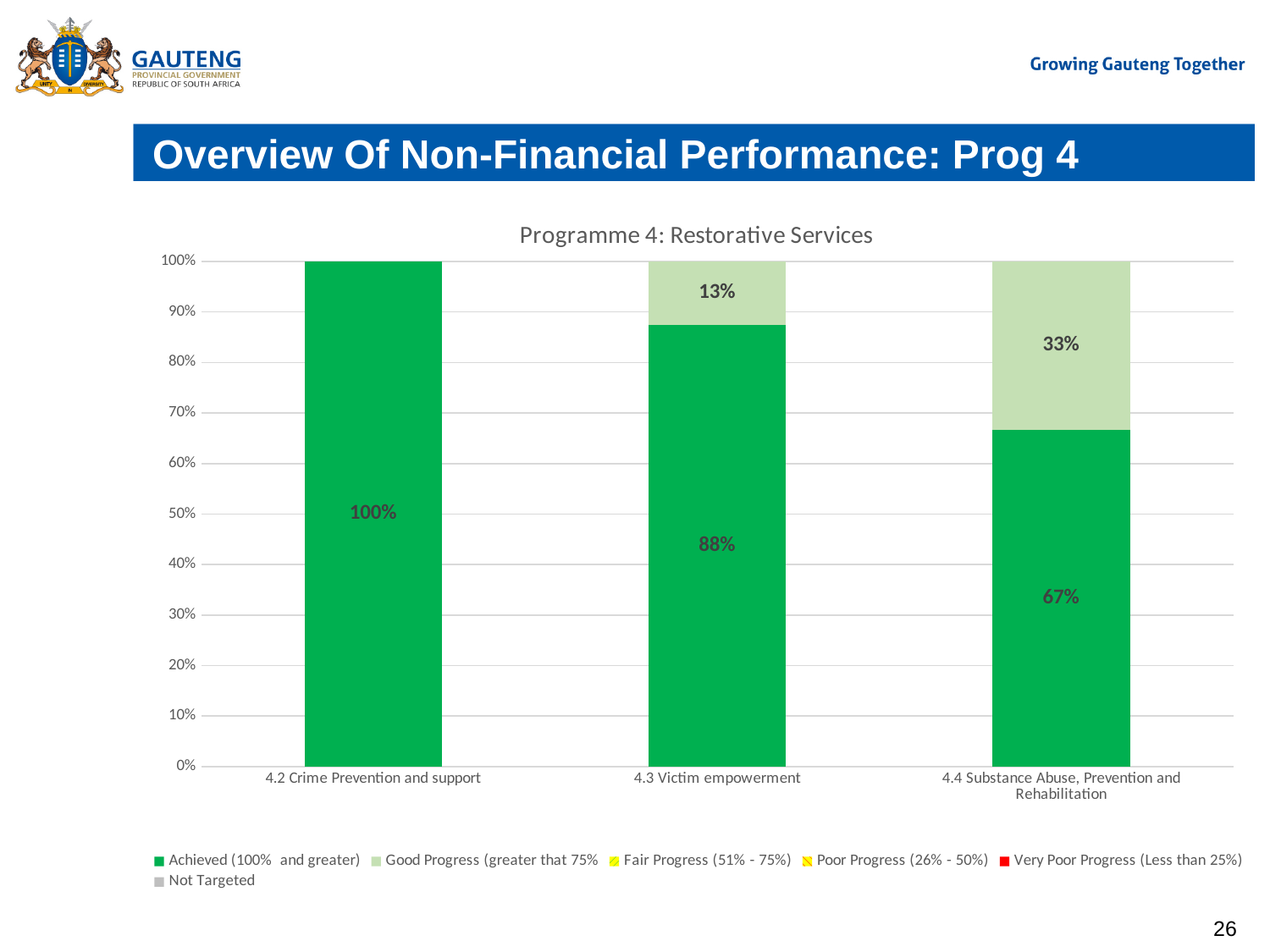
Which is larger: the Good Progress value for 4.3 Victim empowerment or for 4.4 Substance Abuse, Prevention and Rehabilitation? 4.4 Substance Abuse, Prevention and Rehabilitation Which category has the highest Achieved (100% and greater) value? 4.2 Crime Prevention and support What is the Good Progress (greater that 75%) value for 4.3 Victim empowerment? 13% What is the Good Progress (greater that 75%) value for 4.4 Substance Abuse, Prevention and Rehabilitation? 33% Which category has the lowest Achieved (100% and greater) value? 4.4 Substance Abuse, Prevention and Rehabilitation What kind of chart is shown on the slide? Stacked bar chart What is the Achieved (100% and greater) value for 4.2 Crime Prevention and support? 100% How many series does the chart legend list? 6 What is the difference between the Achieved values for 4.3 Victim empowerment and 4.4 Substance Abuse, Prevention and Rehabilitation? 21% How many categories are shown on the x axis of the chart? 3 What is the title of the chart? Programme 4: Restorative Services What is the Achieved (100% and greater) value for 4.3 Victim empowerment? 88%